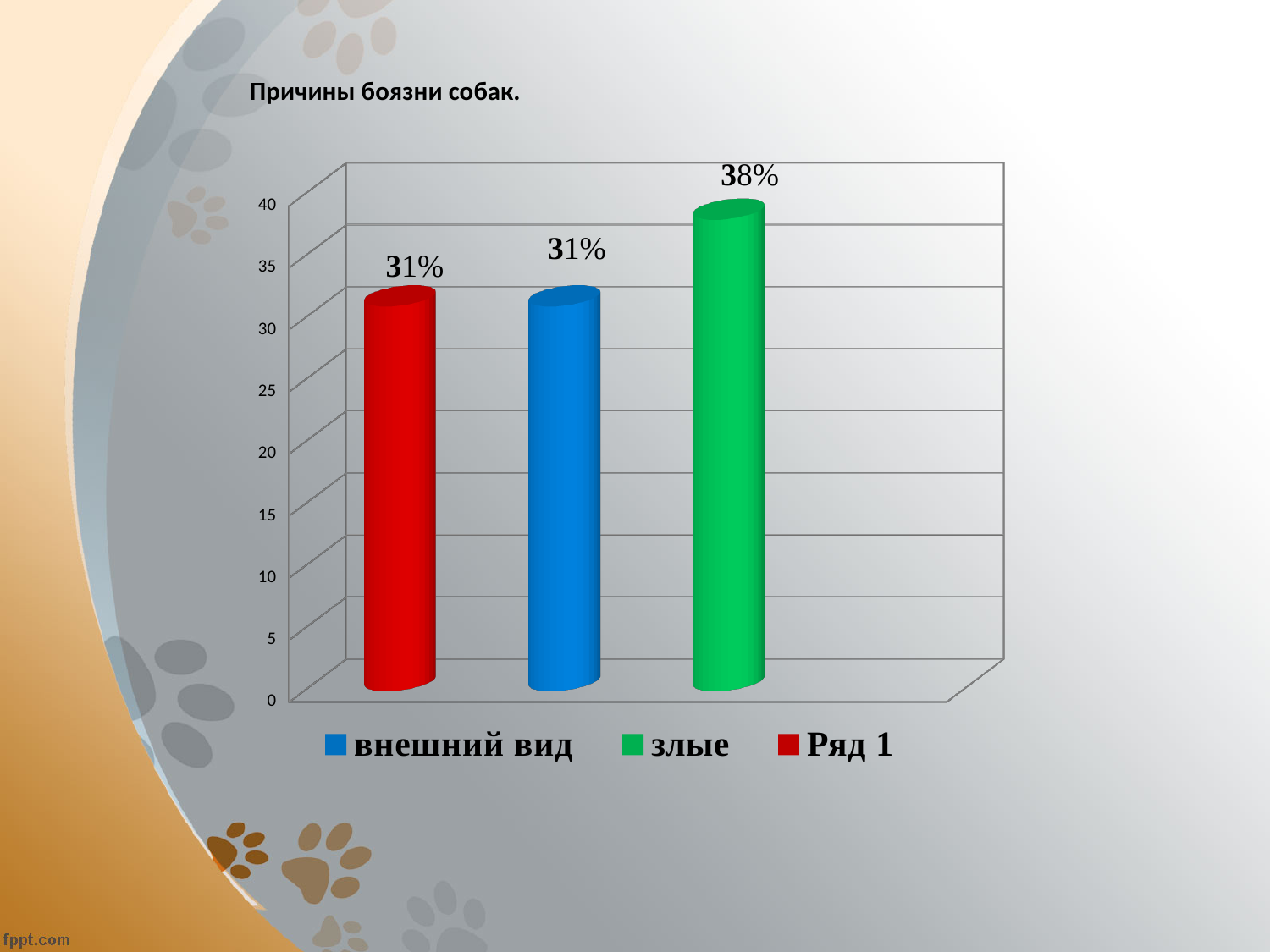
What is the value for внешний вид? 31% What is the value for Ряд 1? 31% How many series does the legend list? 3 Which is larger, the value for злые or the value for Ряд 1? злые What kind of chart is shown on the slide? bar chart Is the value for злые greater or less than 35? greater What is the difference between the values for злые and внешний вид? 7% What is the value for злые? 38% Which series has the highest value? злые Is the value for внешний вид greater or less than 35? less What colour is the bar for злые? green How many bars are plotted in the chart? 3